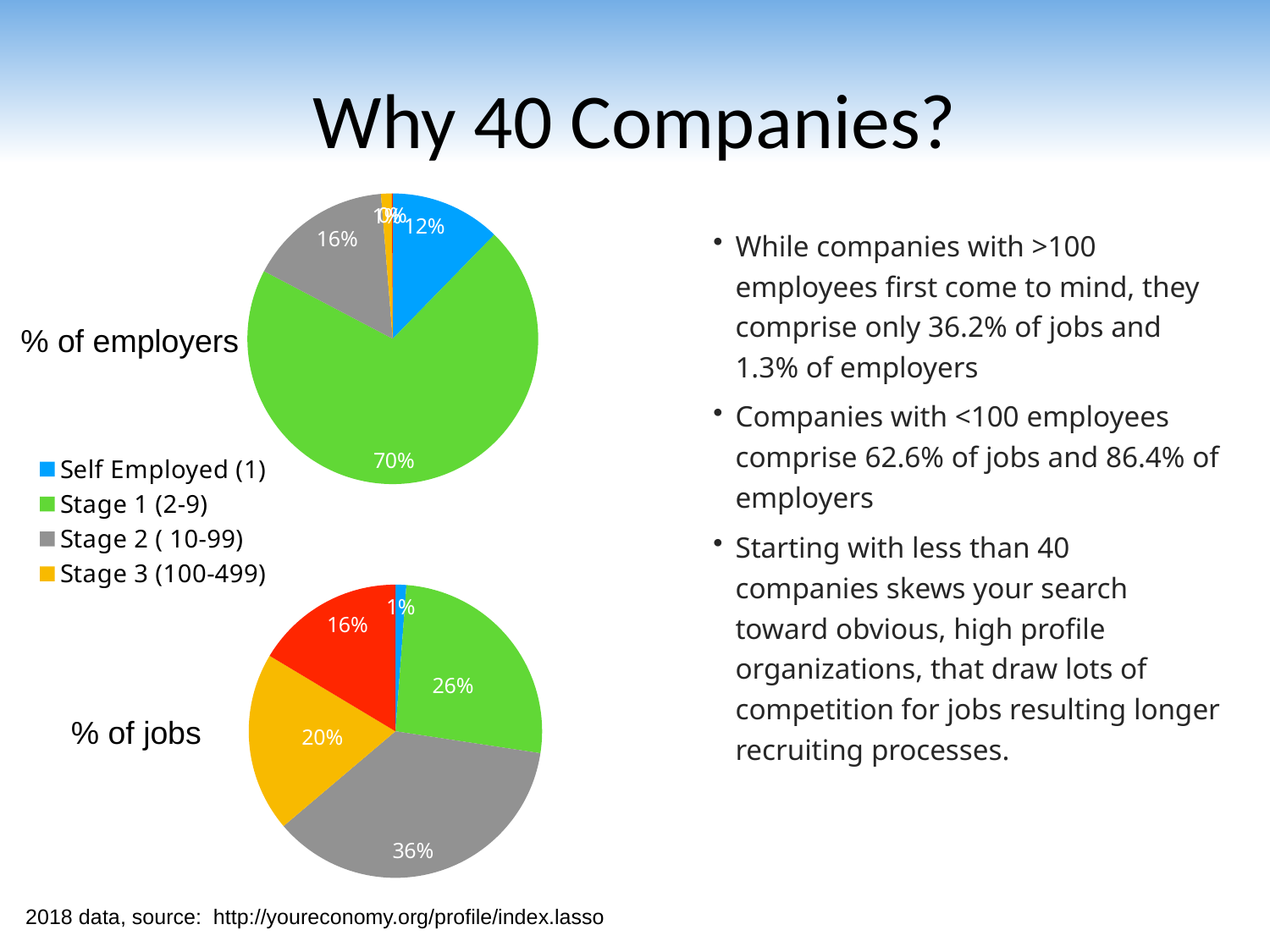
In the "% of jobs" pie chart, which category has the largest slice? Stage 2 (10-99) In the "% of jobs" pie chart, what share is shown for Stage 2 (10-99)? 36% How many entries does the legend on the slide list? 4 In the "% of employers" pie chart, which is larger: Self Employed (1) or Stage 2 (10-99)? Stage 2 (10-99) In the "% of employers" pie chart, what share is shown for Stage 2 (10-99)? 16% In the "% of employers" pie chart, which category has the largest slice? Stage 1 (2-9) In the "% of jobs" pie chart, what share is shown for Stage 3 (100-499)? 20% In the "% of employers" pie chart, what share is shown for Stage 1 (2-9)? 70% In the "% of jobs" pie chart, what share is shown for Stage 1 (2-9)? 26% What kind of chart is used for the "% of employers" data on the slide? Pie chart In the "% of jobs" pie chart, how many percentage points larger is Stage 2 (10-99) than Stage 1 (2-9)? 10 percentage points In the "% of employers" pie chart, what share is shown for Self Employed (1)? 12%